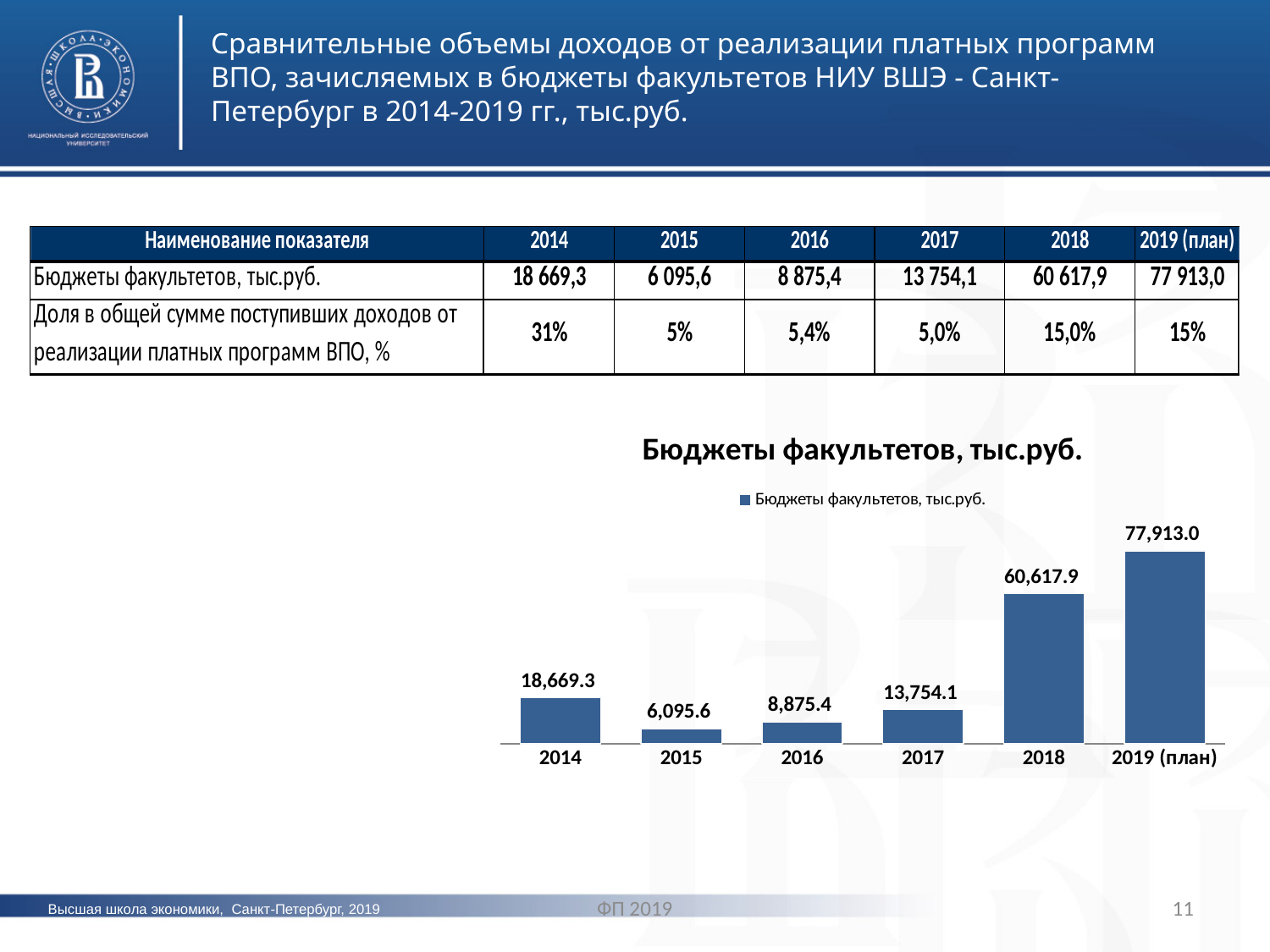
How many categories are shown on the x axis of the chart? 6 Which is larger, the value for 2014 or the value for 2017? 2014 What is the difference between the values for 2014 and 2015? 12,573.7 What is the value for 2019 (план) in the chart? 77,913.0 Which category has the highest value in the chart? 2019 (план) Which category has the lowest value in the chart? 2015 From 2015 to 2019 (план), do the values rise or fall? rise What is the difference between the values for 2019 (план) and 2018? 17,295.1 What is the value for 2015 in the chart? 6,095.6 What kind of chart is shown on the slide? bar chart How many series does the chart legend list? 1 What is the value for 2018 in the chart? 60,617.9